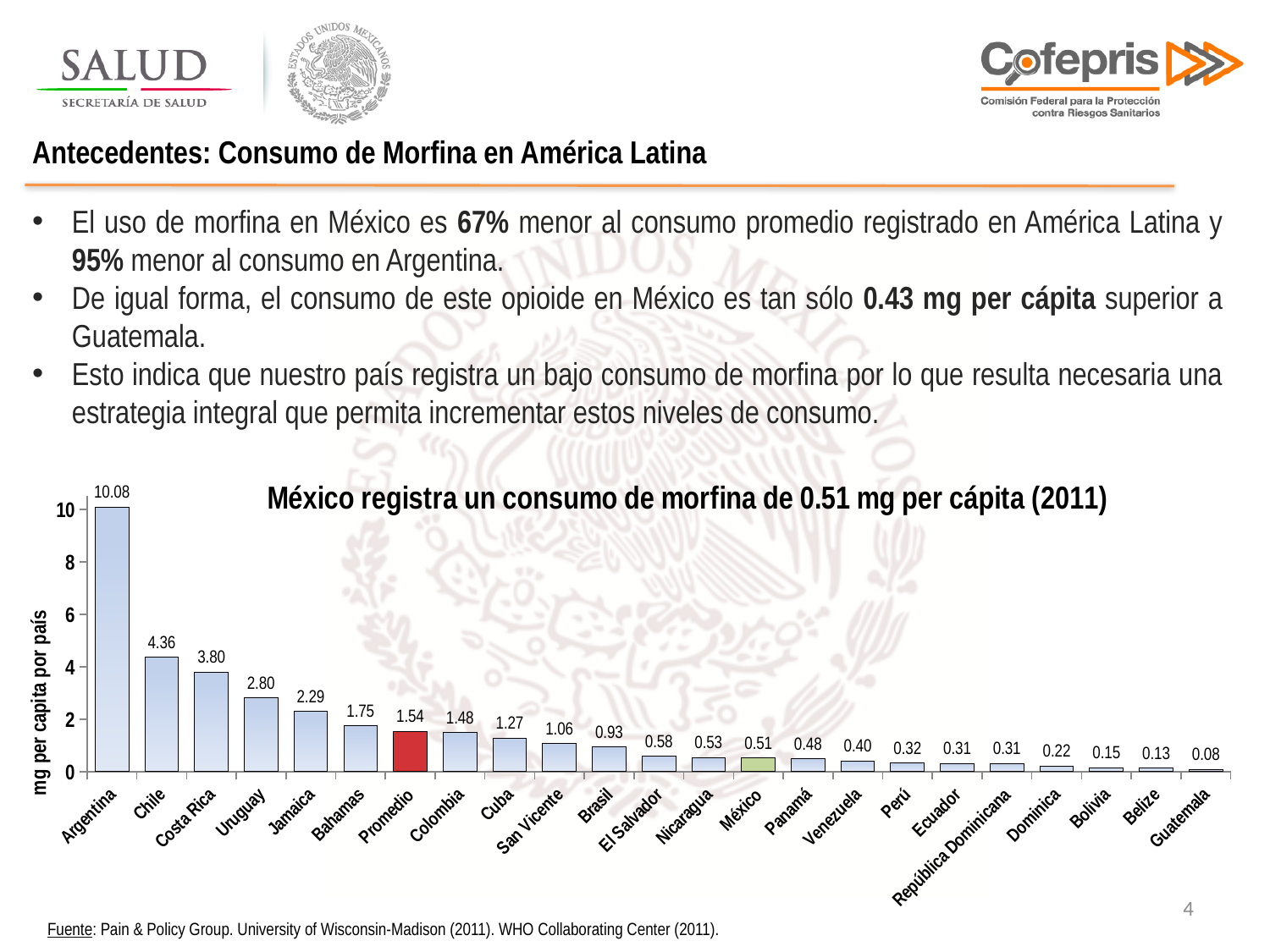
How many countries or categories are shown in the chart? 23 What is the value for Promedio in the chart? 1.54 What is the value for Argentina in the chart? 10.08 What is the value for Guatemala in the chart? 0.08 Which country has the highest value in the chart? Argentina What is the difference between the values for México and Guatemala? 0.43 Which is larger, the value for Colombia or the value for Cuba? Colombia Which country has the lowest value in the chart? Guatemala What is the value for México in the chart? 0.51 Do the values rise or fall from left to right along the x axis? Fall What is the difference between the values for Chile and Costa Rica? 0.56 What kind of chart is shown on the slide? Bar chart